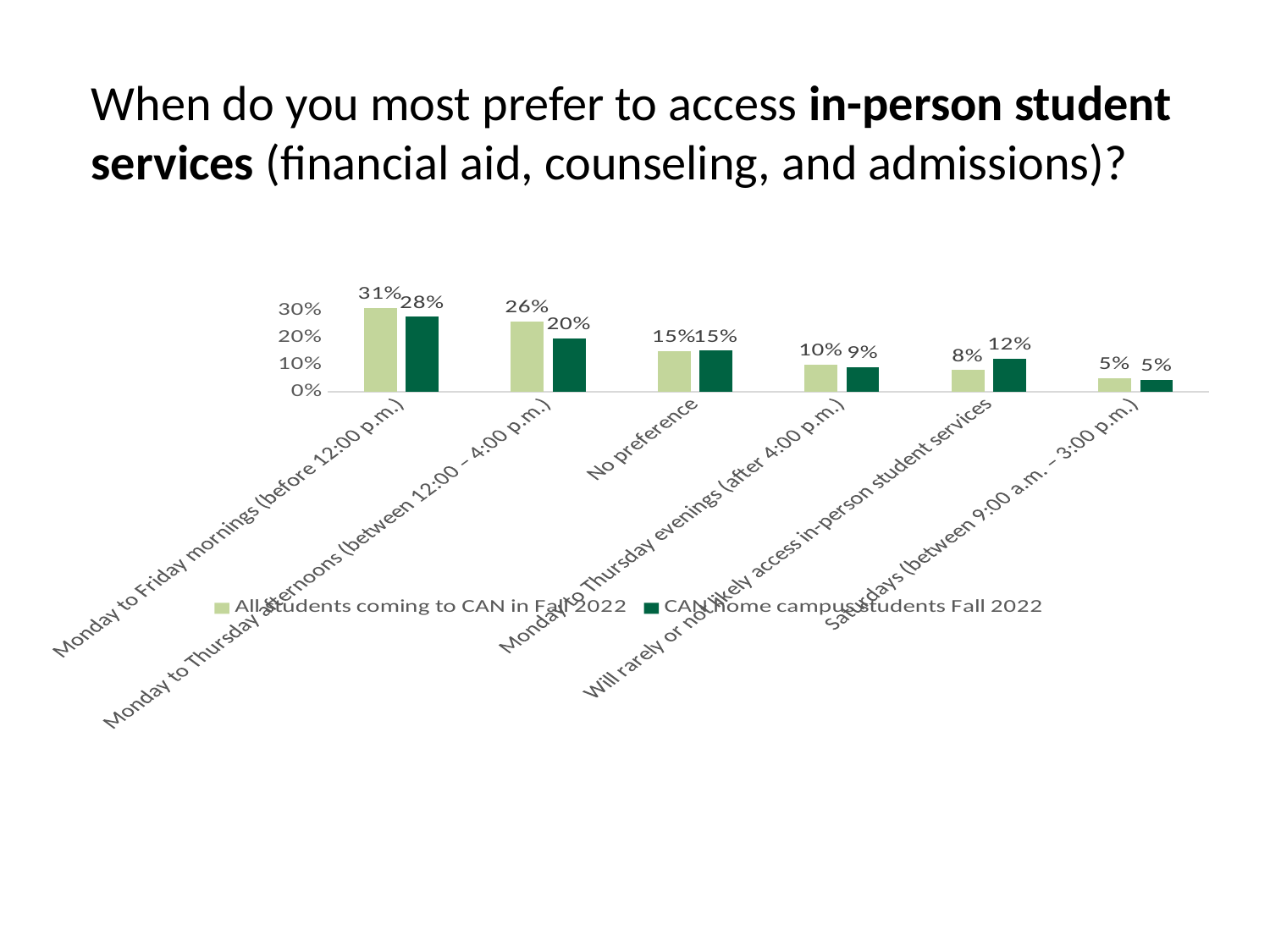
For 'Will rarely or not likely access in-person student services', which series has the larger value? CAN home campus students Fall 2022 How many categories are shown on the x axis of the chart? 6 Which category has the lowest value for CAN home campus students Fall 2022? Saturdays (between 9:00 a.m. – 3:00 p.m.) What percentage of all students coming to CAN in Fall 2022 prefer Monday to Friday mornings (before 12:00 p.m.)? 31% What is the value for CAN home campus students Fall 2022 in the 'Will rarely or not likely access in-person student services' category? 12% What is the difference between the two series for Monday to Thursday afternoons (between 12:00 – 4:00 p.m.)? 6% How many series does the chart legend list? 2 What type of chart is shown on the slide? Bar chart Which category has the highest value for all students coming to CAN in Fall 2022? Monday to Friday mornings (before 12:00 p.m.) What percentage of CAN home campus students Fall 2022 prefer Monday to Thursday afternoons (between 12:00 – 4:00 p.m.)? 20% What is the value for all students coming to CAN in Fall 2022 for Saturdays (between 9:00 a.m. – 3:00 p.m.)? 5% Which series is shown in dark green in the chart? CAN home campus students Fall 2022